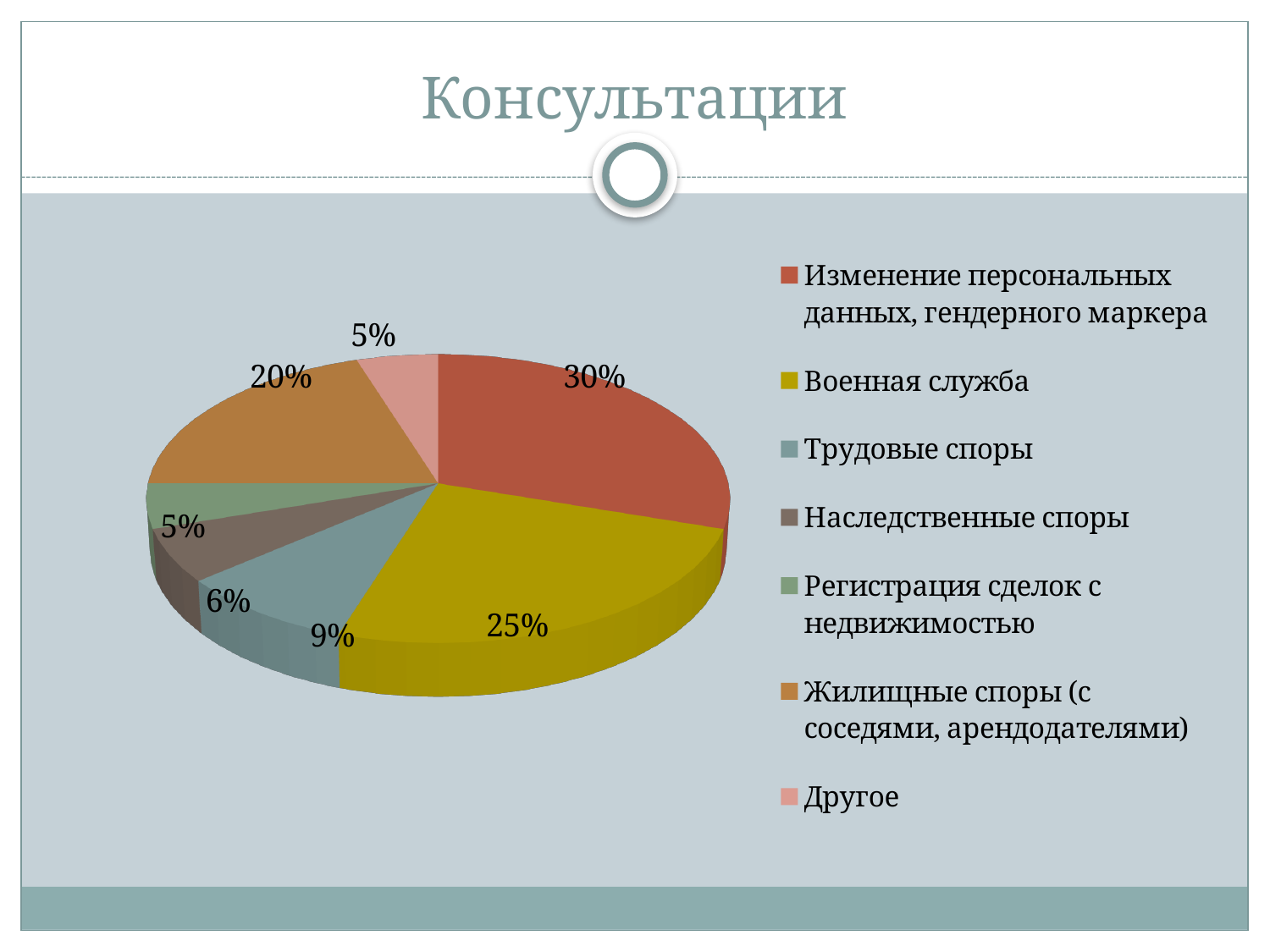
What share of the pie does "Трудовые споры" take? 9% How many categories does the legend list? 7 Which is larger: the share of "Трудовые споры" or the share of "Наследственные споры"? Трудовые споры What share of the pie does "Военная служба" take? 25% What is the title of the slide containing the chart? Консультации What is the difference between the shares of "Изменение персональных данных, гендерного маркера" and "Военная служба"? 5% What share of the pie does "Наследственные споры" take? 6% What share of the pie does "Жилищные споры (с соседями, арендодателями)" take? 20% Which category has the largest slice of the pie? Изменение персональных данных, гендерного маркера What share of the pie does "Изменение персональных данных, гендерного маркера" take? 30% What kind of chart is shown on the slide? pie chart What share of the pie does "Другое" take? 5%